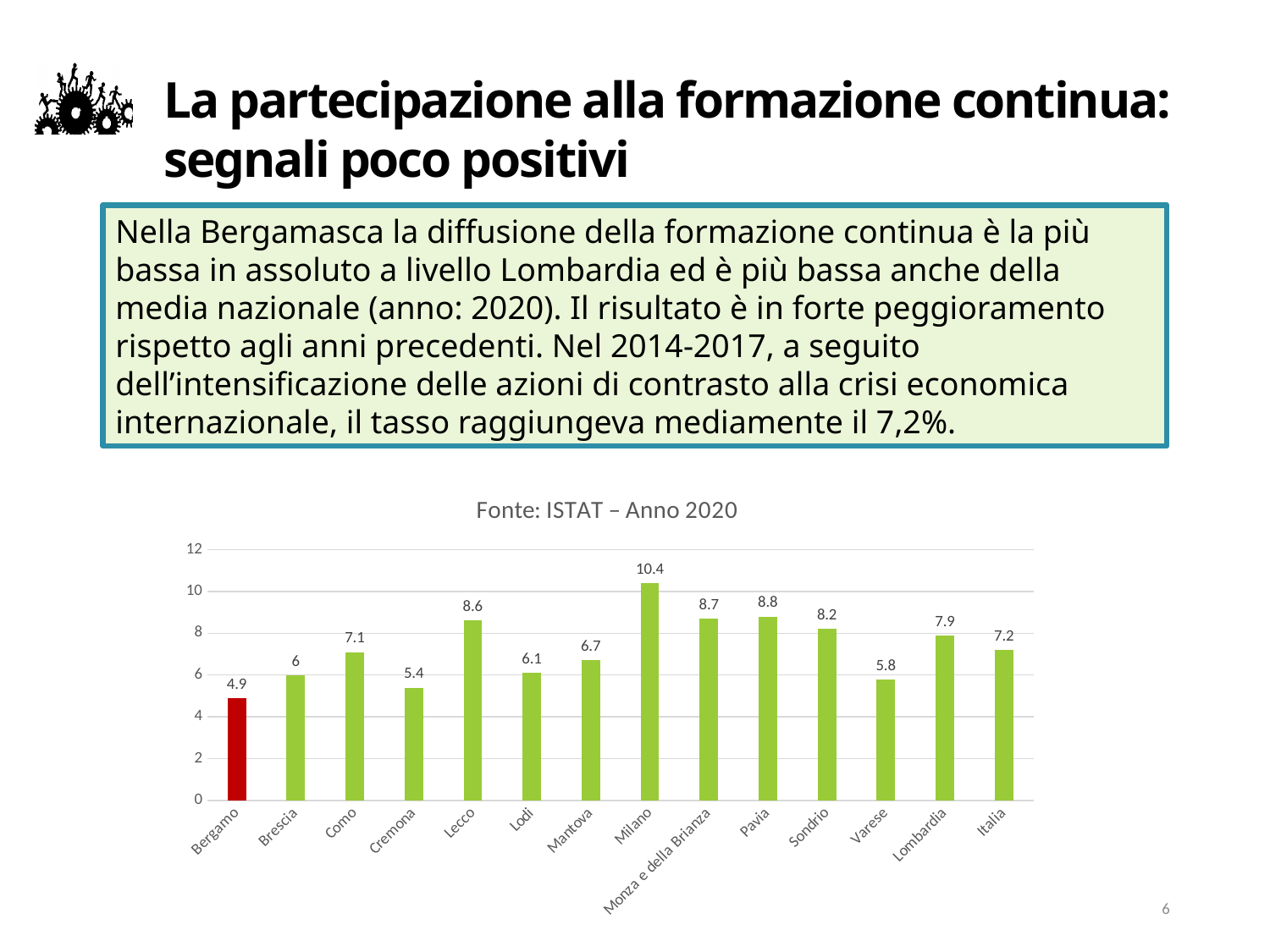
Which is larger, the value for Pavia or the value for Sondrio? Pavia What is the value for Milano? 10.4 What kind of chart is shown on the slide? bar chart Which category has the lowest value? Bergamo Is the value for Lecco greater or less than 8? greater How many categories are shown on the x axis? 14 What is the title of the chart? Fonte: ISTAT – Anno 2020 What is the value for Bergamo? 4.9 Which category has the highest value? Milano What is the value for Lombardia? 7.9 What is the difference between the values for Milano and Bergamo? 5.5 What is the value for Italia? 7.2